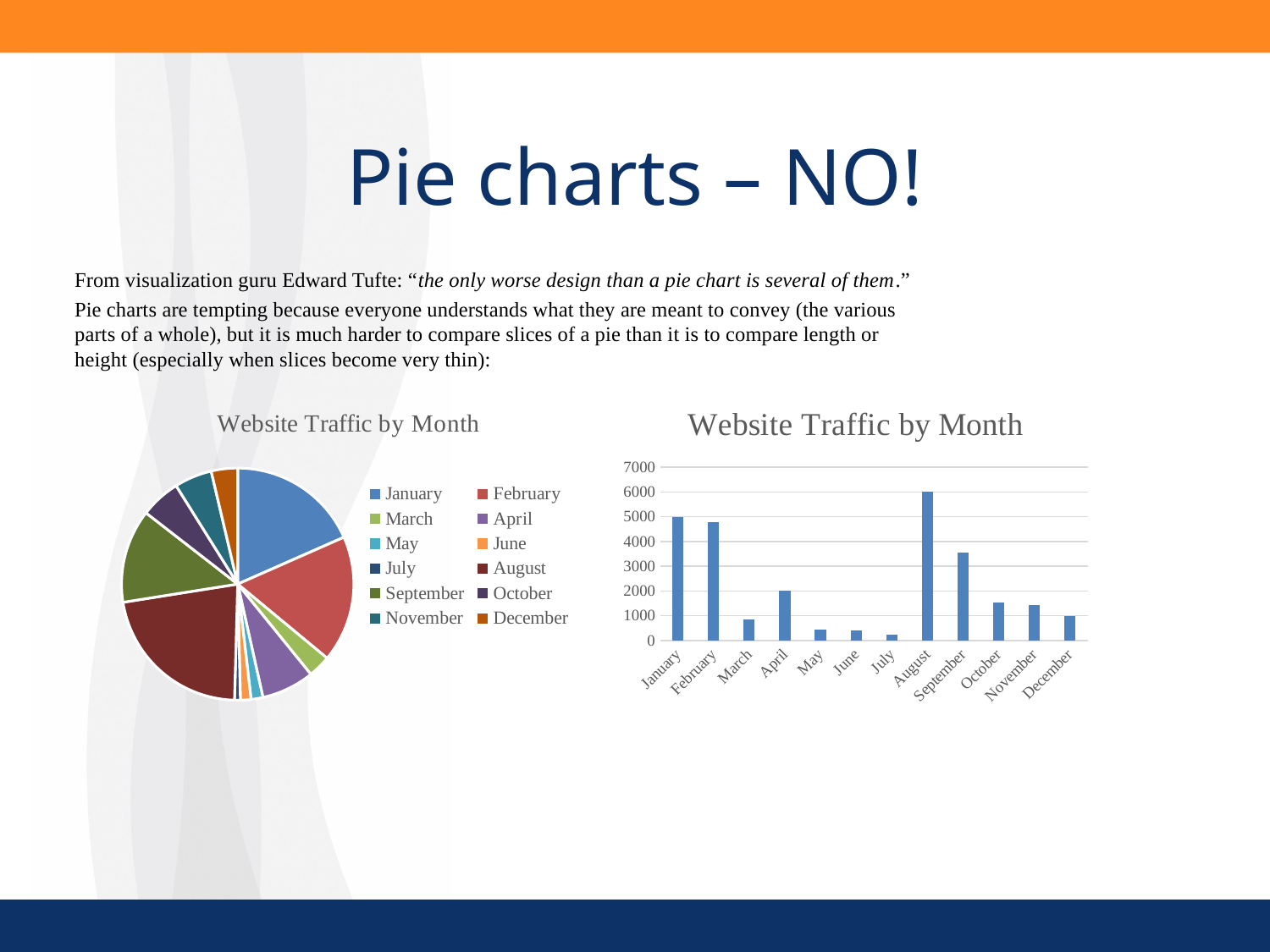
In the bar chart on the right, which month has the highest website traffic? August In the bar chart on the right, which month has the lowest website traffic? July In the bar chart on the right, do the values rise or fall from August through December? fall In the pie chart on the left, which month has the largest slice? August In the bar chart on the right, how many months are shown on the x axis? 12 In the bar chart on the right, which month has higher traffic, September or October? September In the pie chart on the left, how many entries does the legend list? 12 In the bar chart on the right, is the value for October greater or less than 1000? greater In the bar chart on the right, is the value for September greater or less than 3000? greater What kind of chart is the right chart titled 'Website Traffic by Month'? bar chart In the bar chart on the right, is the value for March greater or less than 1000? less What kind of chart is the left chart titled 'Website Traffic by Month'? pie chart